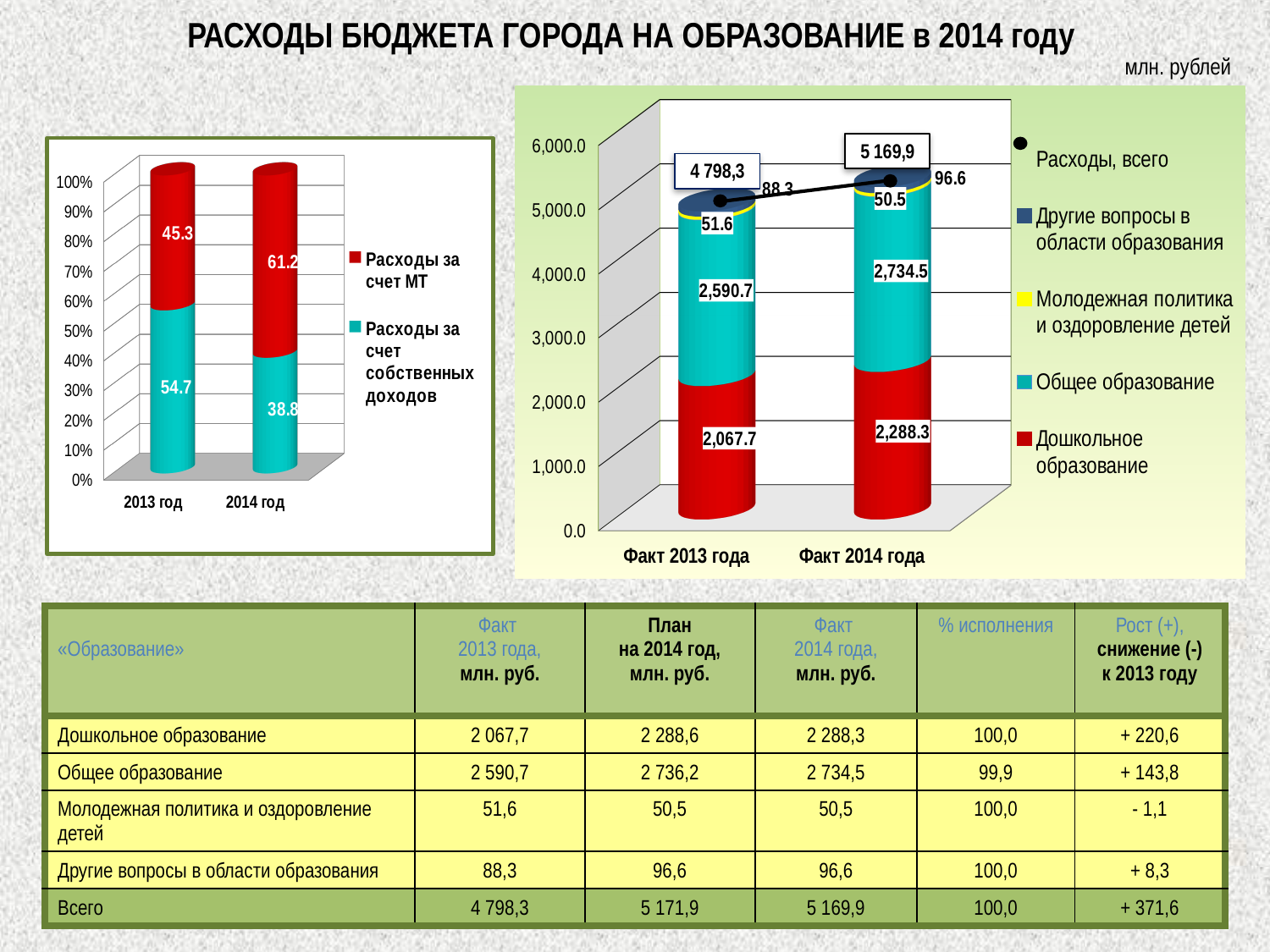
In the right chart, how many series does the legend list? 5 In the left chart, which series has the larger value for 2014 год: 'Расходы за счет МТ' or 'Расходы за счет собственных доходов'? Расходы за счет МТ In the right chart, what is the value of 'Расходы, всего' for Факт 2014 года? 5 169,9 In the right chart, what is the value of 'Дошкольное образование' for Факт 2014 года? 2,288.3 In the right chart, what is the value of 'Молодежная политика и оздоровление детей' for Факт 2013 года? 51.6 In the right chart, which series has the lowest value for Факт 2014 года? Молодежная политика и оздоровление детей In the right chart, what is the value of 'Общее образование' for Факт 2013 года? 2,590.7 In the left chart, does the value of 'Расходы за счет собственных доходов' rise or fall from 2013 год to 2014 год? fall In the right chart, what is the difference between 'Общее образование' for Факт 2014 года and Факт 2013 года? 143.8 In the left chart, what is the value of 'Расходы за счет МТ' for 2013 год? 45.3 In the left chart, what is the value of 'Расходы за счет собственных доходов' for 2014 год? 38.8 In the left chart, how many series does the legend list? 2